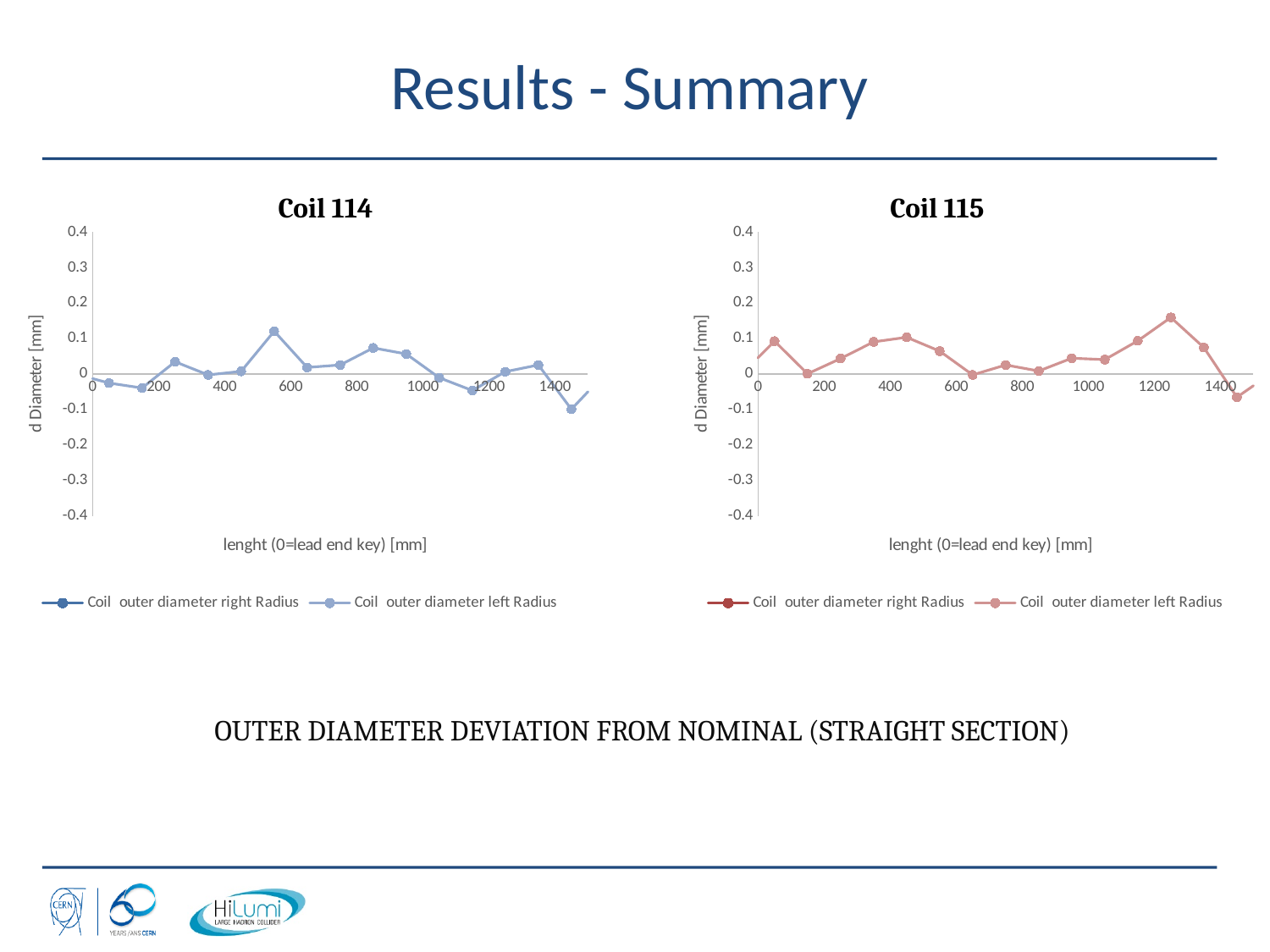
In the Coil 115 chart, which is larger: the value at length 450 or the value at length 650? 450 In the Coil 114 chart, is the value at length 550 greater or less than 0? greater What is the y-axis title of the Coil 114 chart? d Diameter [mm] In the Coil 114 chart, at which x value (length) does the plotted line reach its highest point? 550 In the Coil 114 chart, is the value at length 1450 greater or less than 0? less In the Coil 115 chart, is the value at length 1250 greater or less than 0.1? greater In the Coil 114 chart, at which x value (length) does the plotted line reach its lowest point? 1450 What is the x-axis title of the Coil 115 chart? lenght (0=lead end key) [mm] In the Coil 115 chart, at which x value (length) does the plotted line reach its highest point? 1250 How many series does the legend of the Coil 115 chart list? 2 What kind of chart is the Coil 114 chart? line chart